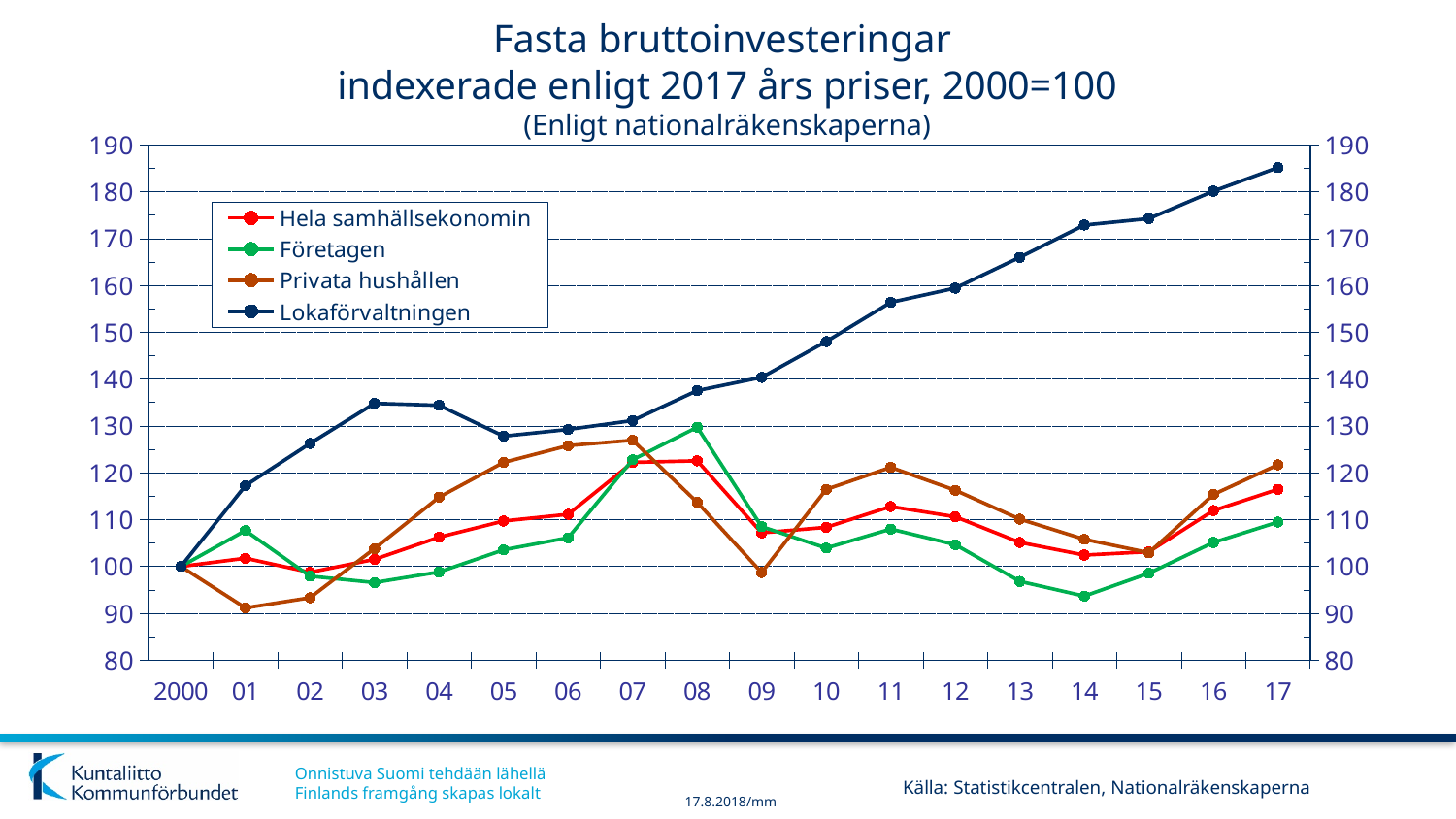
What is the value for Lokalförvaltningen in 2000? 100 Is the value for Lokalförvaltningen in 2017 greater or less than 180? greater Which series has the highest value in 2017? Lokalförvaltningen What kind of chart is shown on the slide? line chart How many years are plotted along the x axis? 18 How many series does the legend list? 4 Does the Lokalförvaltningen series rise or fall from 2009 to 2017? rise In 2009, which is larger: the value for Privata hushållen or the value for Lokalförvaltningen? Lokalförvaltningen Is the value for Företagen in 2008 greater or less than 120? greater Is the value for Privata hushållen in 2001 greater or less than 100? less Which series has the lowest value in 2017? Företagen